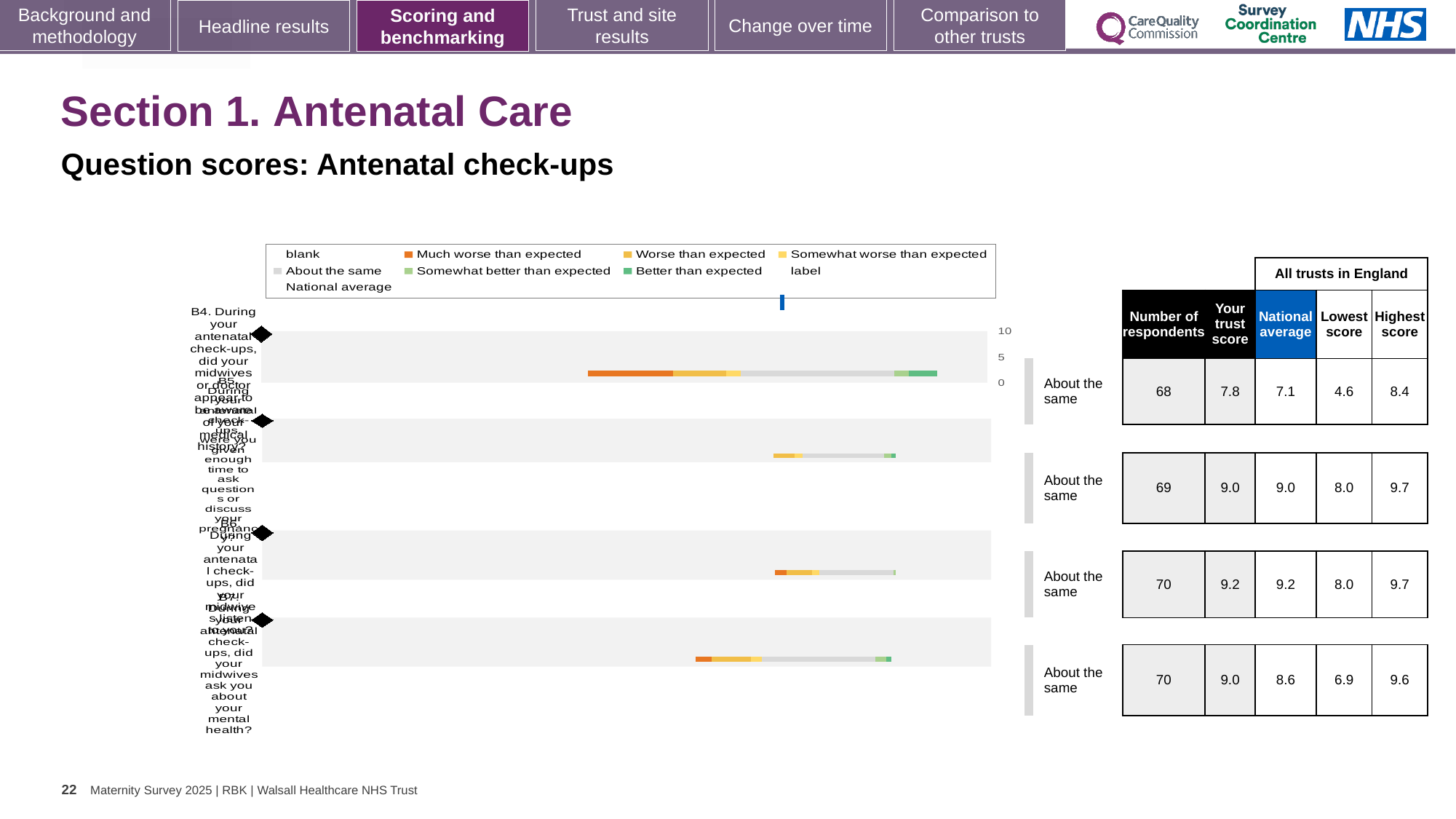
What is the highest score among all trusts in England for the fourth row (midwives asking about your mental health)? 9.6 What kind of chart is used to show the question scores for antenatal check-ups? Bar chart For the fourth row (midwives asking about your mental health), which is larger: the trust score or the national average? The trust score (9.0) What colour represents 'Much worse than expected' in the chart legend? Orange By how much does the trust score for question B4 exceed the national average? 0.7 What benchmark category is shown for question B4 (midwives or doctor aware of your medical history)? About the same How many questions (rows) are plotted in the antenatal check-ups chart? 4 What is the number of respondents for question B4 (midwives or doctor aware of your medical history)? 68 Which row of the chart has the lowest 'Lowest score' among all trusts in England? The first row, B4 (4.6) What is the trust score for question B4 (midwives or doctor aware of your medical history)? 7.8 Which row of the chart has the highest trust score? The third row (9.2) What is the national average for question B4 (midwives or doctor aware of your medical history)? 7.1